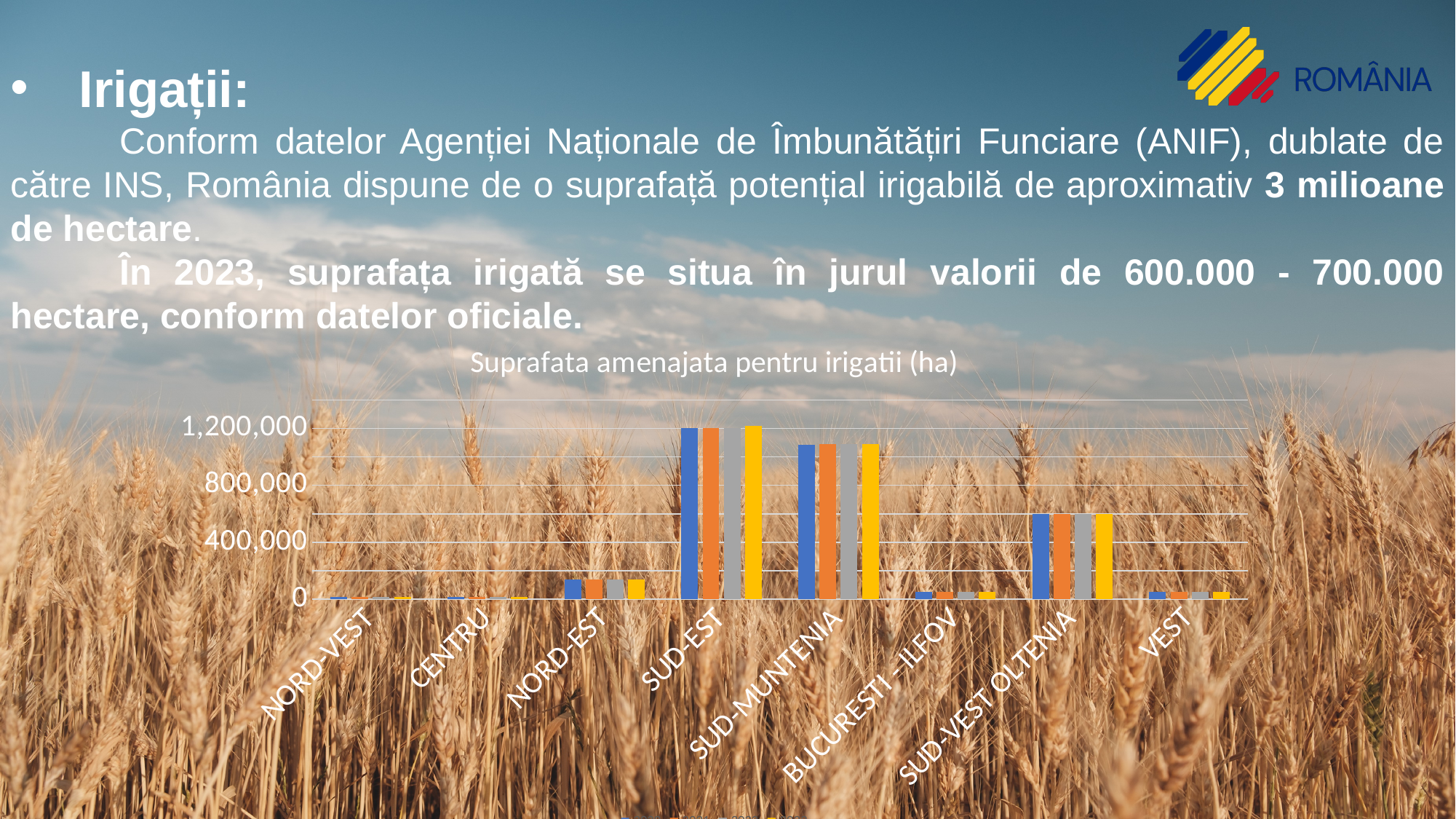
Are the values for NORD-EST greater or less than 400,000? less Are the values for SUD-MUNTENIA greater or less than 800,000? greater Which region has larger values, SUD-EST or SUD-MUNTENIA? SUD-EST What is the title of the chart on the slide? Suprafata amenajata pentru irigatii (ha) Are the values for SUD-VEST OLTENIA greater or less than 400,000? greater What kind of chart is shown on the slide? bar chart How many bars are plotted for each region in the chart? 4 Which region has larger values, NORD-EST or SUD-VEST OLTENIA? SUD-VEST OLTENIA How many regions (categories) are shown on the x axis of the chart? 8 Which region has the highest values in the chart? SUD-EST